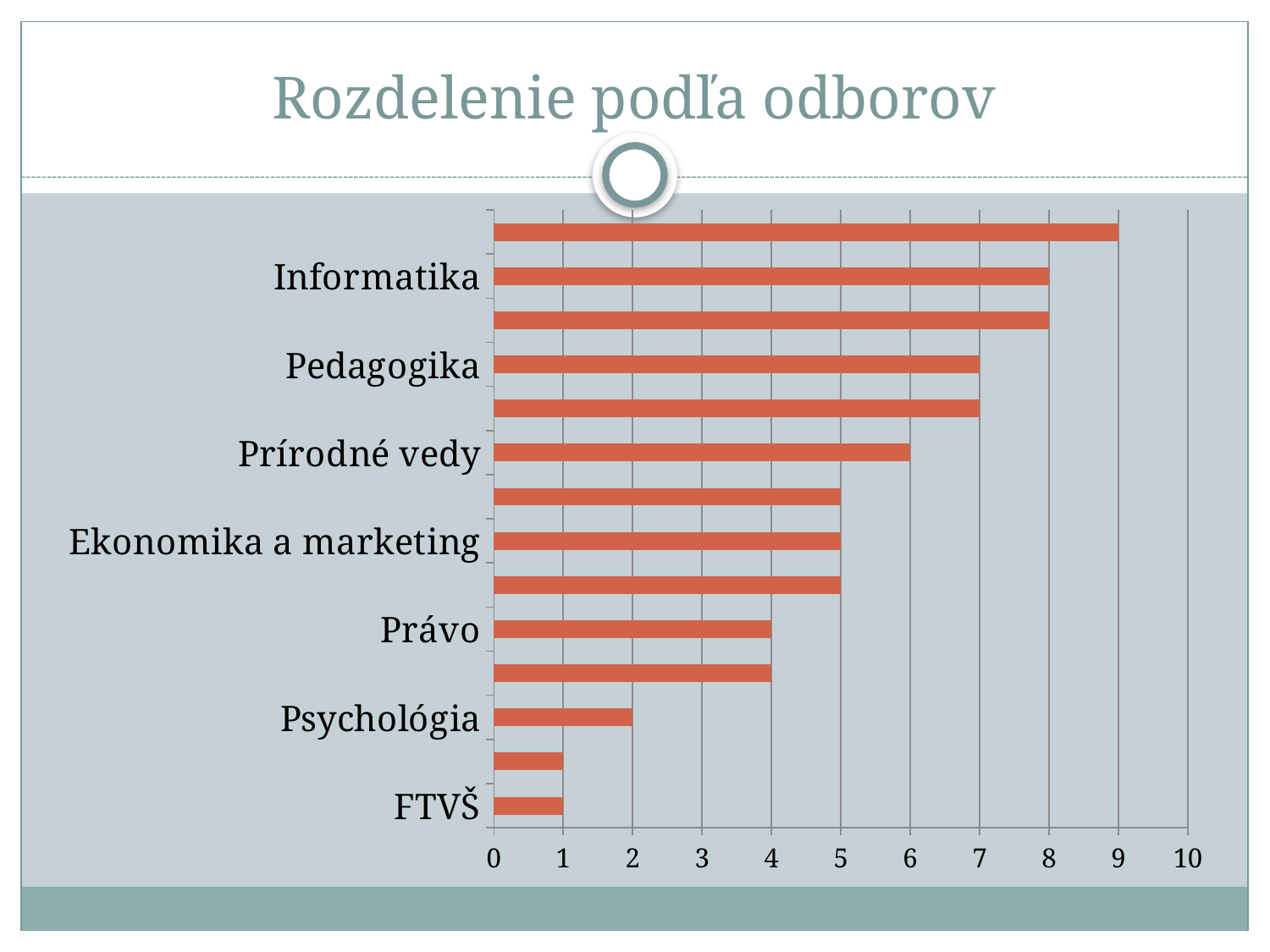
What is the value for Pedagogika? 7 What is the title of the slide? Rozdelenie podľa odborov What is the value for FTVŠ? 1 What is the difference between the values for Informatika and Právo? 4 What kind of chart is shown on the slide? Bar chart What is the value for Psychológia? 2 What is the value for Prírodné vedy? 6 What is the value for Právo? 4 What is the value for Informatika? 8 Among the labelled categories, which has the lowest value? FTVŠ What is the value for Ekonomika a marketing? 5 Which is larger, the value for Pedagogika or the value for Psychológia? Pedagogika